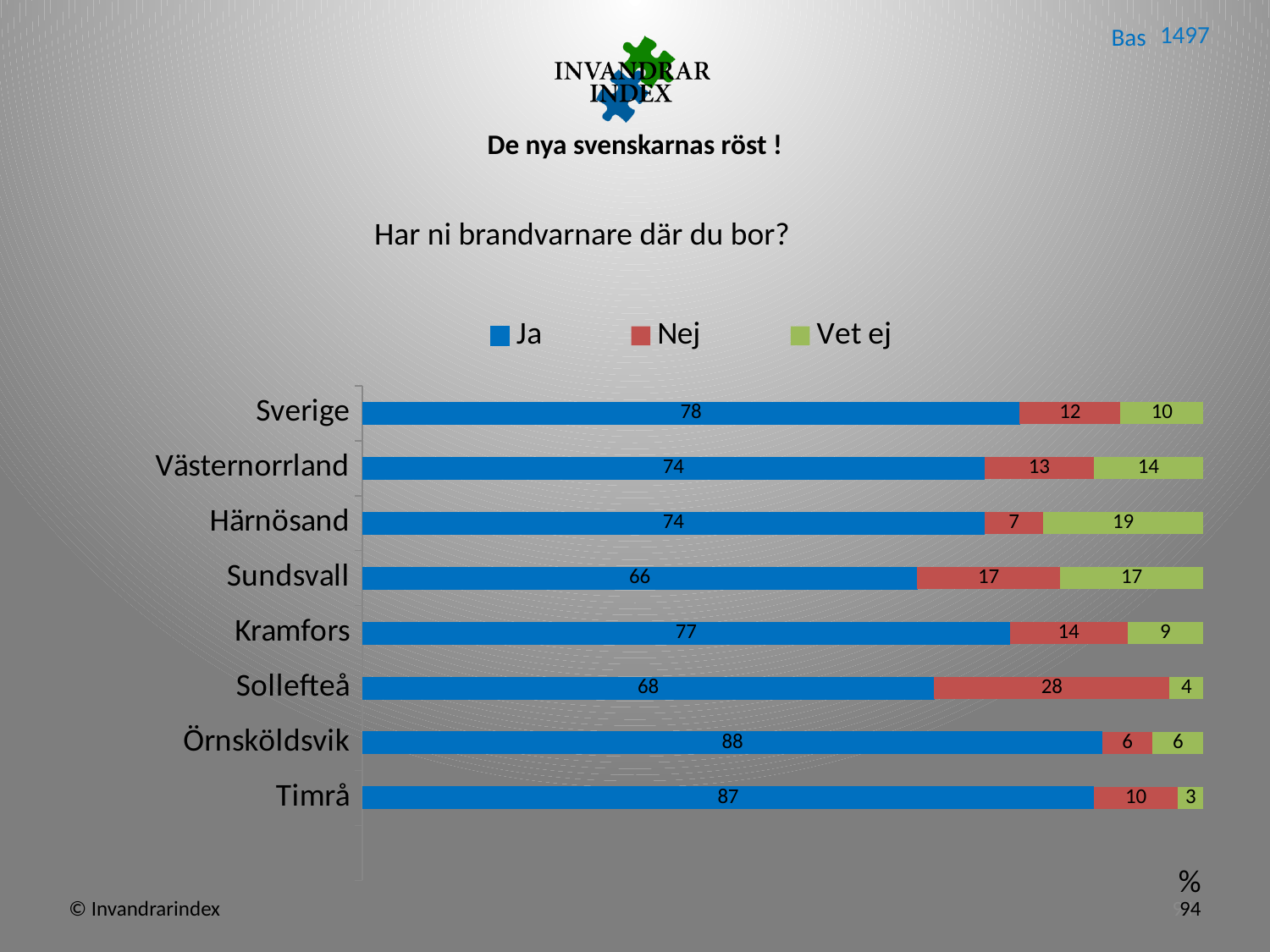
Which category has the lowest Ja value? Sundsvall Which category has the highest Nej value? Sollefteå What is the difference between the Ja values for Sverige and Sundsvall? 12 What kind of chart is shown on the slide? Stacked bar chart Which category has the lowest Vet ej value? Timrå How many categories are shown on the chart? 8 What is the Vet ej value for Härnösand? 19 What is the Ja value for Sundsvall? 66 What is the Nej value for Sollefteå? 28 Which is larger, the Nej value for Sundsvall or the Nej value for Kramfors? Sundsvall How many series does the legend list? 3 Which category has the highest Ja value? Örnsköldsvik